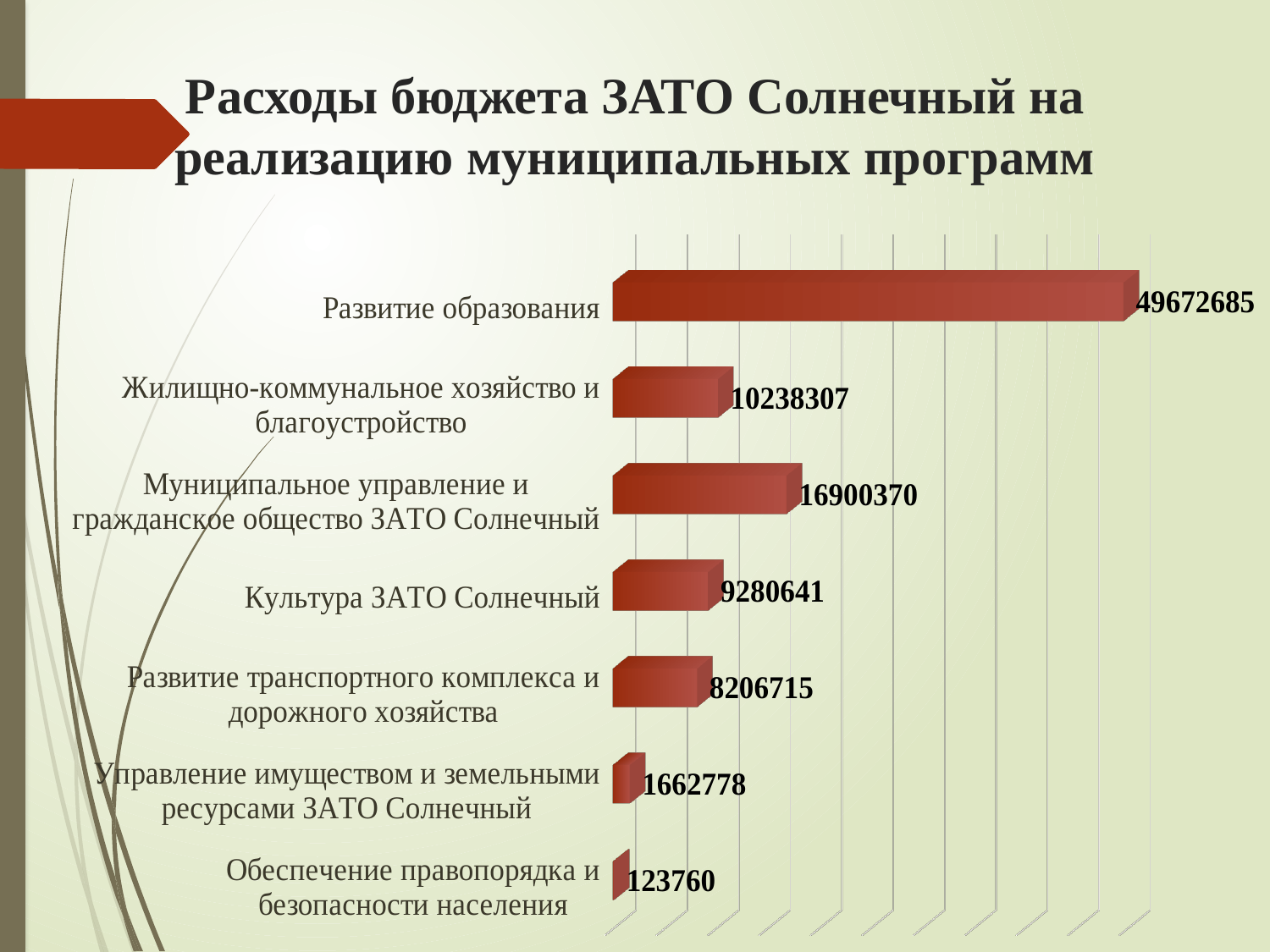
Which category has the lowest value? Обеспечение правопорядка и безопасности населения What is the value for Обеспечение правопорядка и безопасности населения? 123760 What is the value for Культура ЗАТО Солнечный? 9280641 What is the difference between the values for Жилищно-коммунальное хозяйство и благоустройство and Культура ЗАТО Солнечный? 957666 What is the difference between the values for Развитие образования and Муниципальное управление и гражданское общество ЗАТО Солнечный? 32772315 What is the title of the slide? Расходы бюджета ЗАТО Солнечный на реализацию муниципальных программ How many categories are shown in the chart? 7 What is the value for Развитие образования? 49672685 What kind of chart is shown on the slide? Bar chart What is the value for Муниципальное управление и гражданское общество ЗАТО Солнечный? 16900370 Which category has the highest value? Развитие образования Which is larger: the value for Развитие транспортного комплекса и дорожного хозяйства or the value for Управление имуществом и земельными ресурсами ЗАТО Солнечный? Развитие транспортного комплекса и дорожного хозяйства